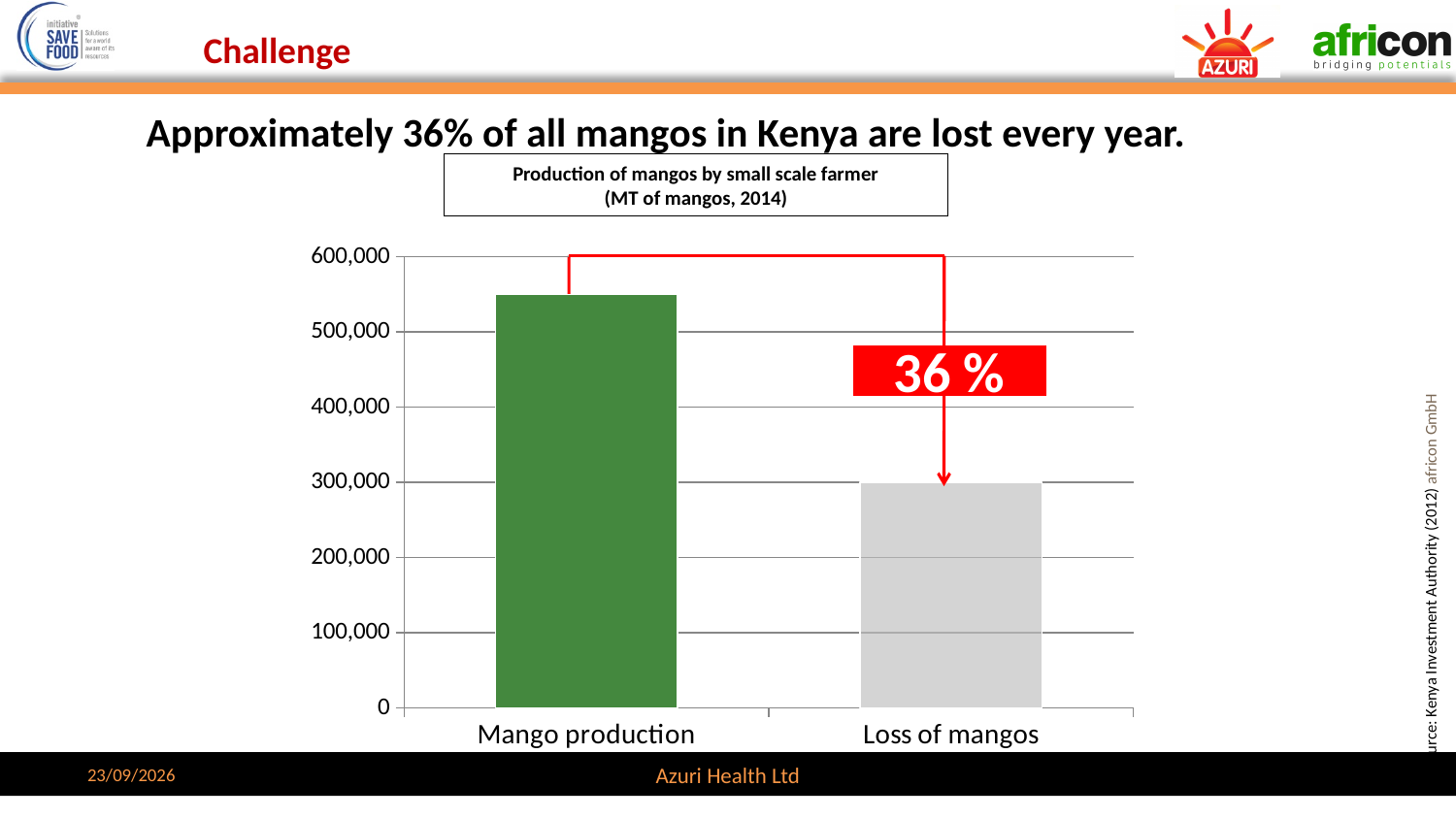
What is the title of the chart? Production of mangos by small scale farmer (MT of mangos, 2014) What percentage is shown in the red annotation box between the two bars? 36 % Is the value for Mango production greater or less than 600,000? less Which category has the highest value on the chart? Mango production Is the value for Loss of mangos greater or less than 400,000? less Which category has the lowest value on the chart? Loss of mangos Which is larger, the value for Mango production or the value for Loss of mangos? Mango production Is the value for Mango production greater or less than 500,000? greater How many categories are plotted on the chart? 2 What kind of chart is shown on the slide? bar chart